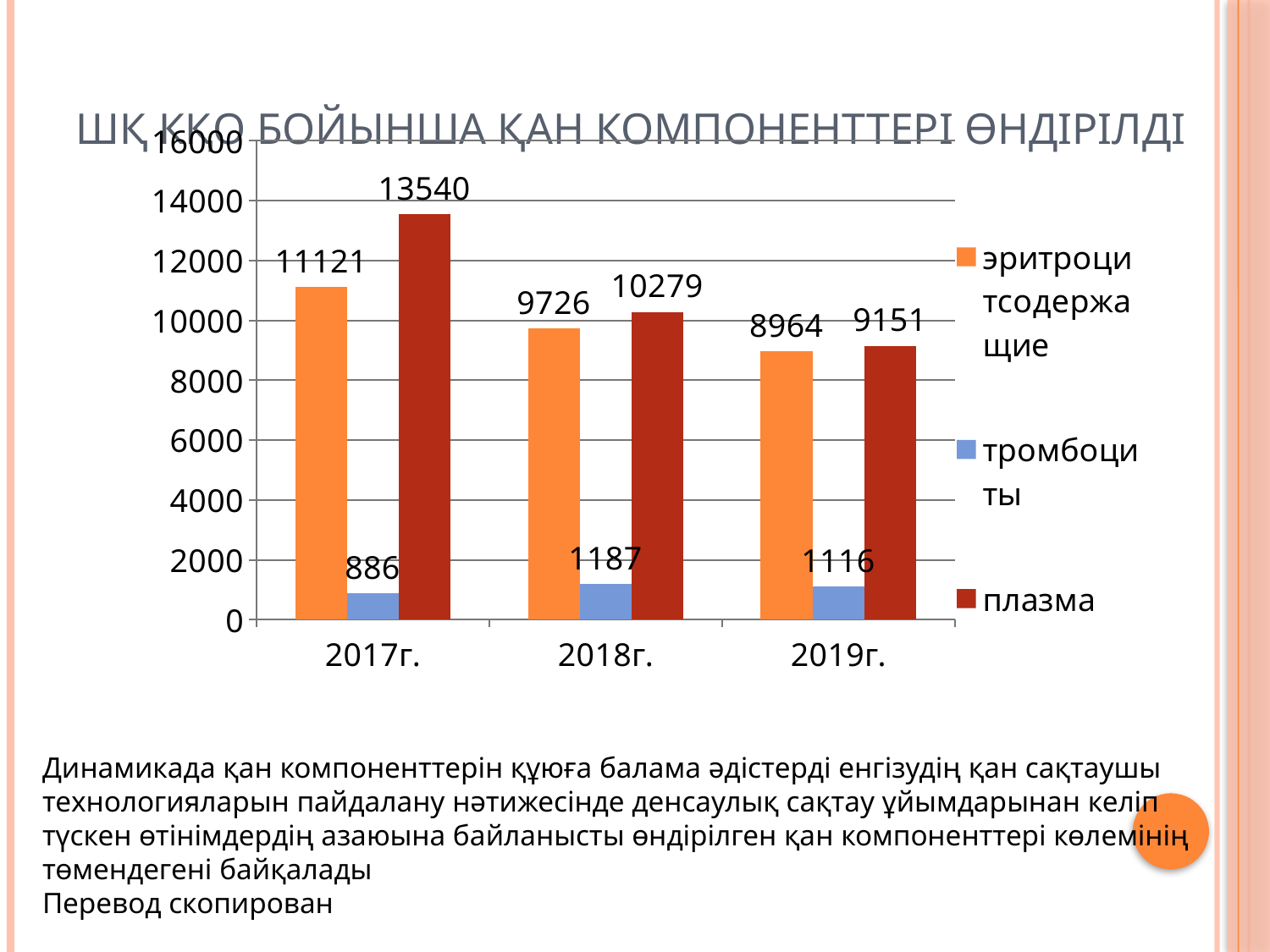
What is the value for тромбоциты in 2018г.? 1187 What is the value for плазма in 2017г.? 13540 What colour are the плазма bars? dark red Which is larger in 2019г., плазма or эритроцитсодержащие? плазма What is the value for эритроцитсодержащие in 2019г.? 8964 Do the эритроцитсодержащие values rise or fall from 2017г. to 2019г.? fall How many years are shown on the x axis? 3 In which year is the плазма value highest? 2017г. In which year is the тромбоциты value lowest? 2017г. How many series does the legend list? 3 What is the difference between the плазма and эритроцитсодержащие values in 2017г.? 2419 What kind of chart is shown on the slide? bar chart